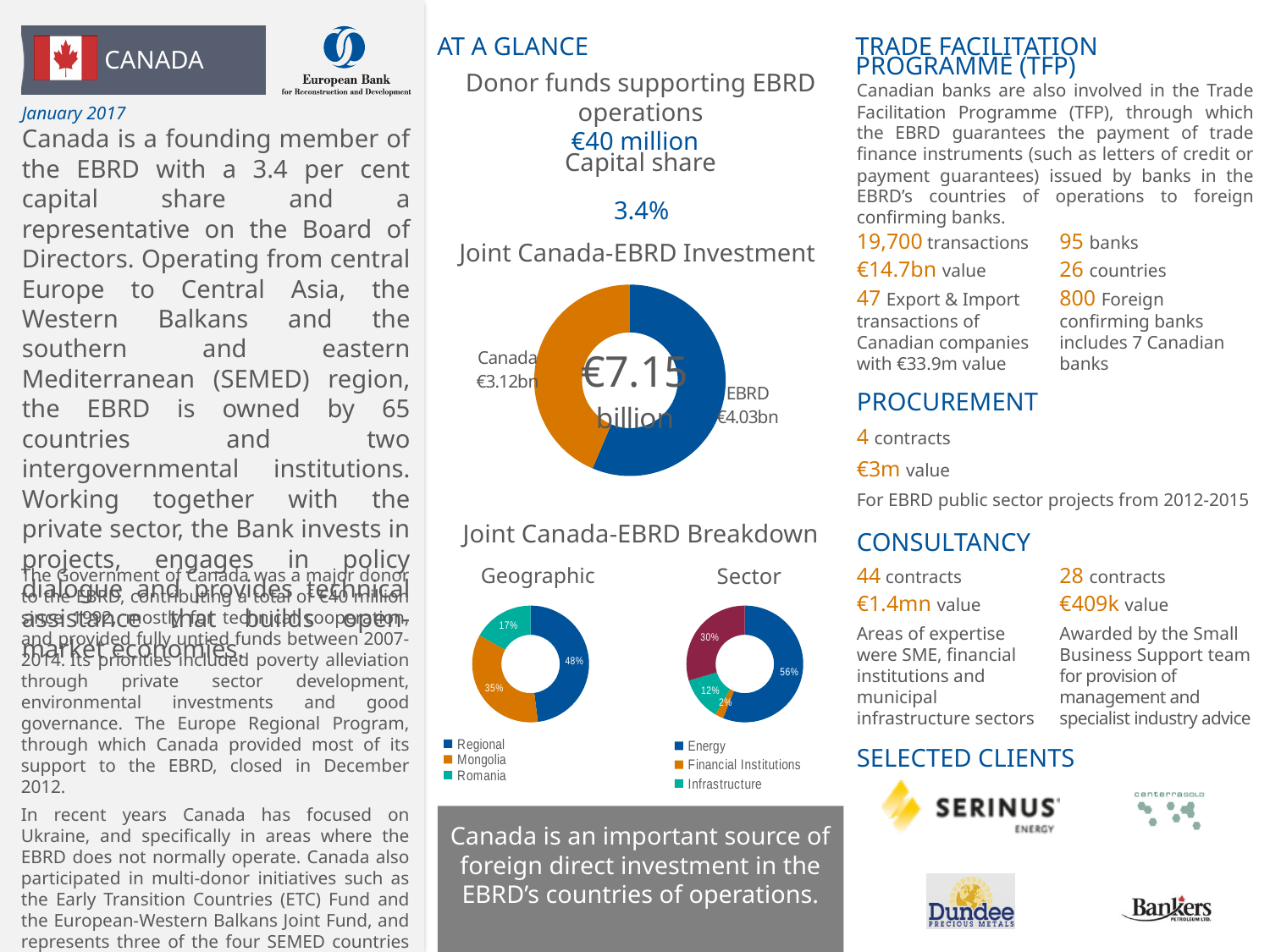
In the Sector breakdown chart, which sector has the largest share? Energy How many categories does the legend of the Geographic breakdown chart list? 3 In the Joint Canada-EBRD Investment chart, what is the difference between the EBRD and Canada values? €0.91bn In the Geographic breakdown chart, what percentage is Regional? 48% In the Sector breakdown chart, what percentage is Energy? 56% In the Joint Canada-EBRD Investment chart, what is the value for Canada? €3.12bn What kind of chart is the Joint Canada-EBRD Investment chart? Donut (pie) chart In the Joint Canada-EBRD Investment chart, what total is shown in the centre of the donut? €7.15 billion In the Geographic breakdown chart, which category has the smallest share? Romania In the Joint Canada-EBRD Investment chart, which contributes more, Canada or EBRD? EBRD In the Joint Canada-EBRD Investment chart, what is the value for EBRD? €4.03bn In the Geographic breakdown chart, what percentage is Mongolia? 35%